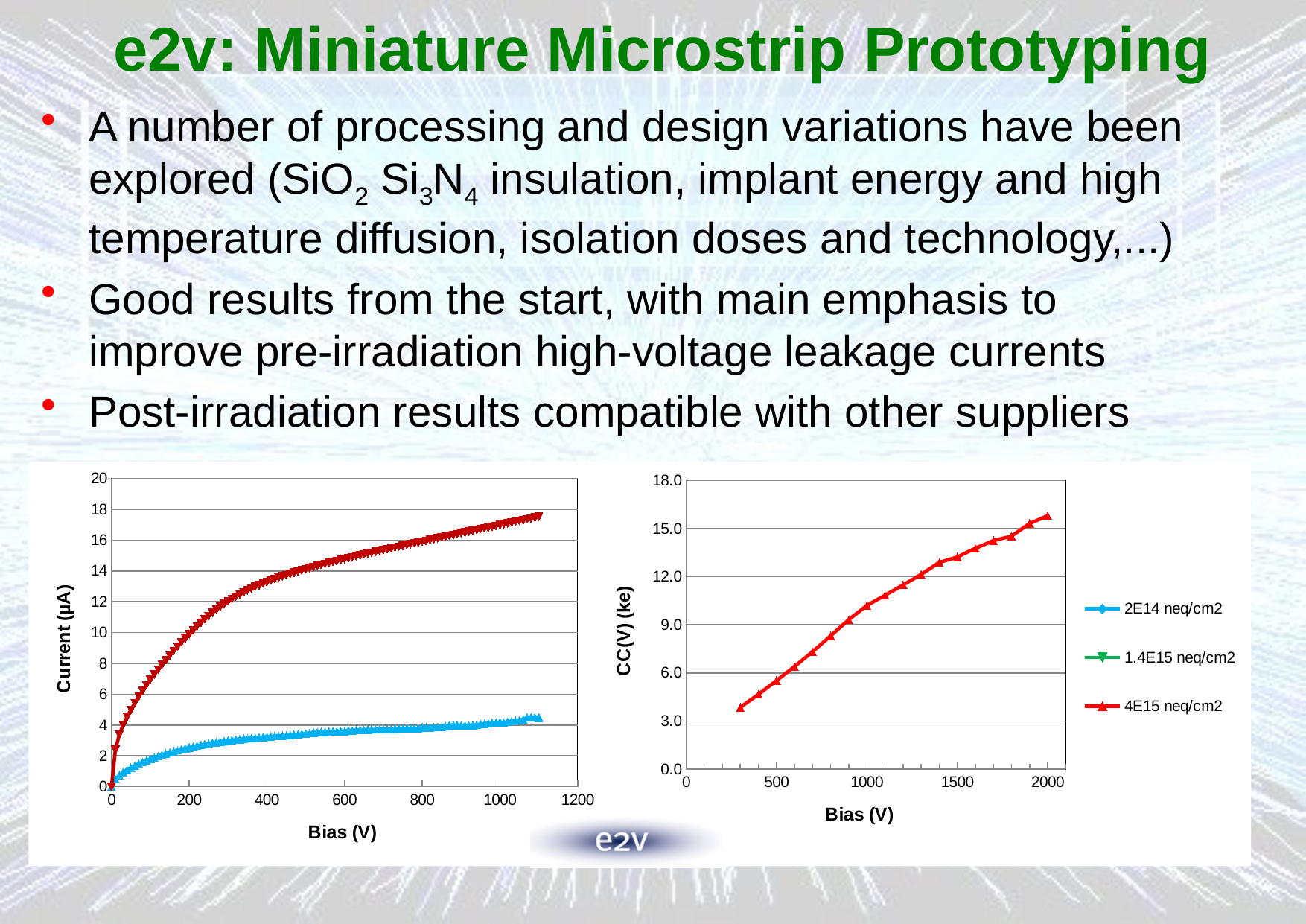
What kind of chart is the left chart (Current vs Bias)? line chart In the right chart (CC(V) vs Bias), is the value of the 4E15 neq/cm2 series at 500 V greater or less than 9.0? less In the right chart (CC(V) vs Bias), does the plotted 4E15 neq/cm2 series rise or fall as Bias increases? rises In the right chart (CC(V) vs Bias), which legend entry is plotted with red triangle markers? 4E15 neq/cm2 What kind of chart is the right chart (CC(V) vs Bias)? line chart How many series does the legend of the right chart (CC(V) vs Bias) list? 3 What is the y-axis title of the left chart? Current (µA) In the left chart (Current vs Bias), which series has the higher current at 600 V, the red series or the blue series? red series In the left chart (Current vs Bias), is the current of the blue series at 1000 V greater or less than 6? less In the right chart (CC(V) vs Bias), is the value of the 4E15 neq/cm2 series at 2000 V greater or less than 15.0? greater